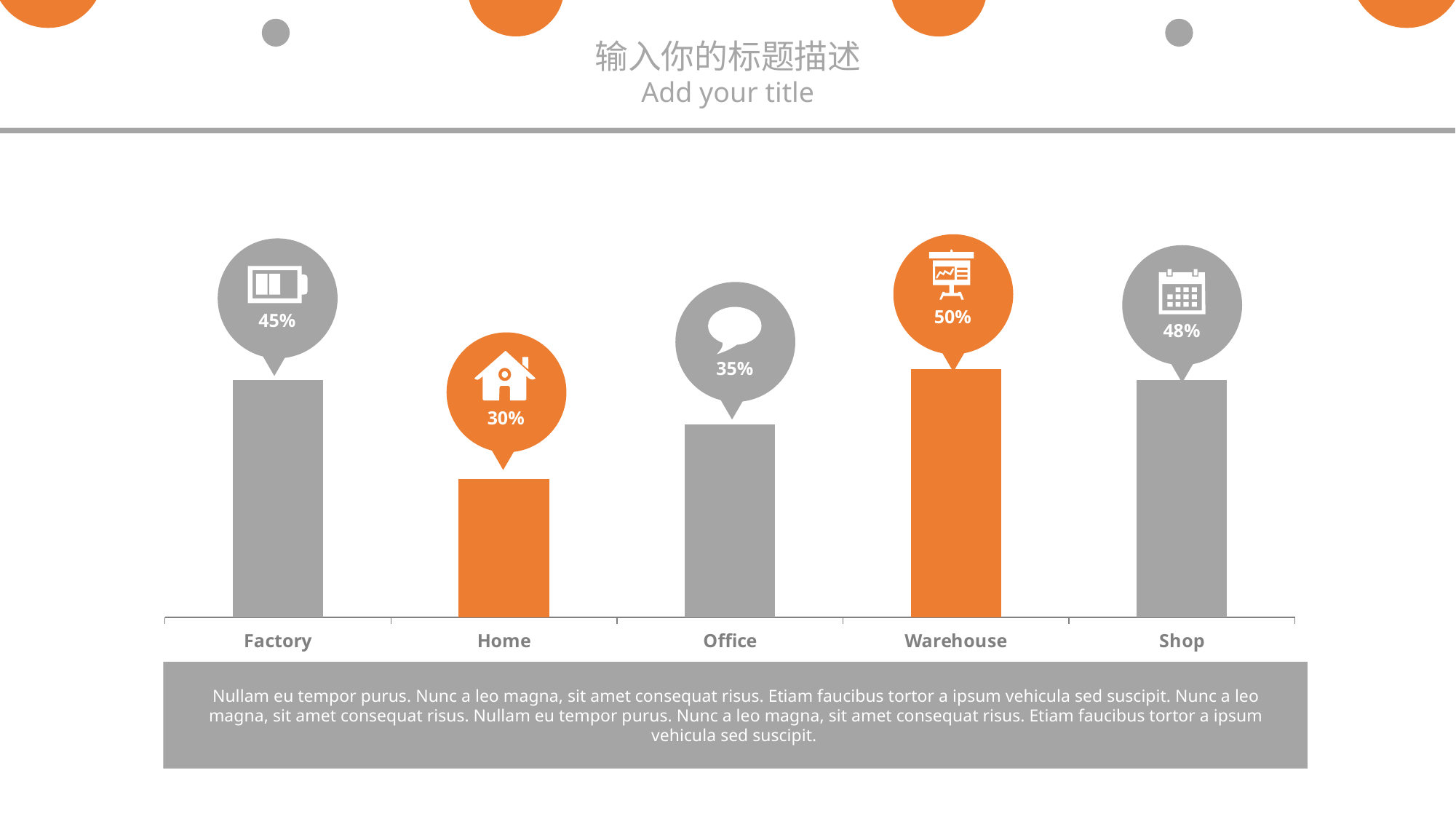
Which category has the lowest value? Home What is the value for Home? 30% How many categories are shown in the chart? 5 Which is larger, the value for Factory or the value for Office? Factory What colour are the bars for Home and Warehouse? Orange What kind of chart is shown on the slide? Bar chart What is the value for Shop? 48% What is the value for Factory? 45% Which category has the highest value? Warehouse What is the difference between the values for Warehouse and Home? 20% What is the value for Office? 35% What is the value for Warehouse? 50%